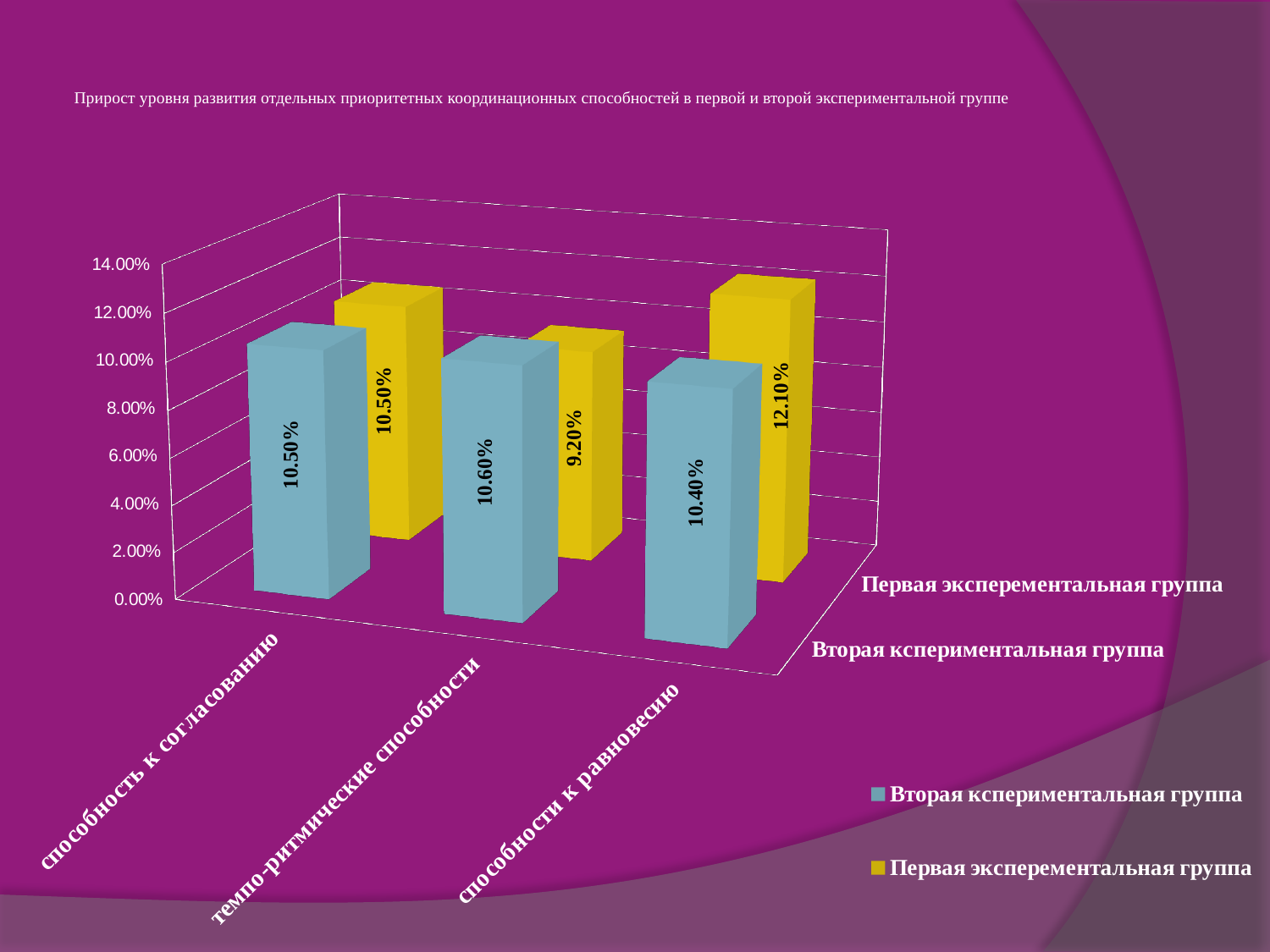
How many categories are shown on the x axis? 3 What type of chart is shown on the slide? bar chart In the category "темпо-ритмические способности", which group has the larger value? Вторая кспериментальная группа What is the value for "Вторая кспериментальная группа" in the category "способность к согласованию"? 10.50% What is the difference between the two groups in the category "способности к равновесию"? 1.70% In which category does "Первая эксперементальная группа" have its highest value? способности к равновесию What is the value for "Вторая кспериментальная группа" in the category "способности к равновесию"? 10.40% Which colour represents "Первая эксперементальная группа" in the chart? yellow What is the value for "Первая эксперементальная группа" in the category "способности к равновесию"? 12.10% In which category does "Первая эксперементальная группа" have its lowest value? темпо-ритмические способности What is the value for "Первая эксперементальная группа" in the category "темпо-ритмические способности"? 9.20% How many series does the legend list? 2